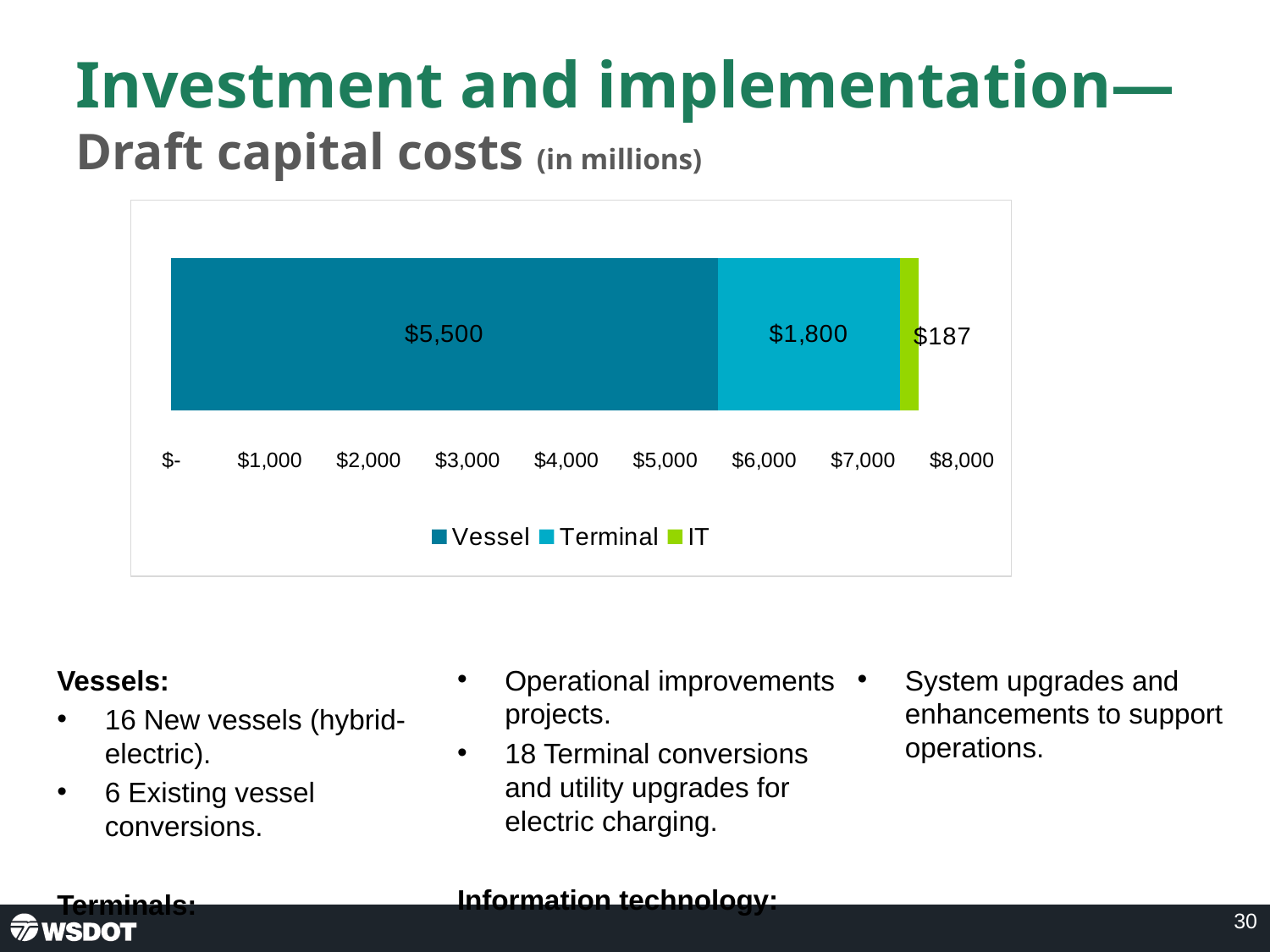
What is the difference between the Terminal and IT values? $1,613 Which is larger, the Terminal value or the IT value? Terminal Which series has the smallest value in the chart? IT What is the total of the stacked bar? $7,487 What is the value of the IT segment in the stacked bar? $187 Which series has the largest value in the chart? Vessel How many series does the legend list? 3 What kind of chart is shown on the slide? Stacked bar chart What is the value of the Vessel segment in the stacked bar? $5,500 What is the highest value shown on the x axis? $8,000 What is the difference between the Vessel and Terminal values? $3,700 What is the value of the Terminal segment in the stacked bar? $1,800